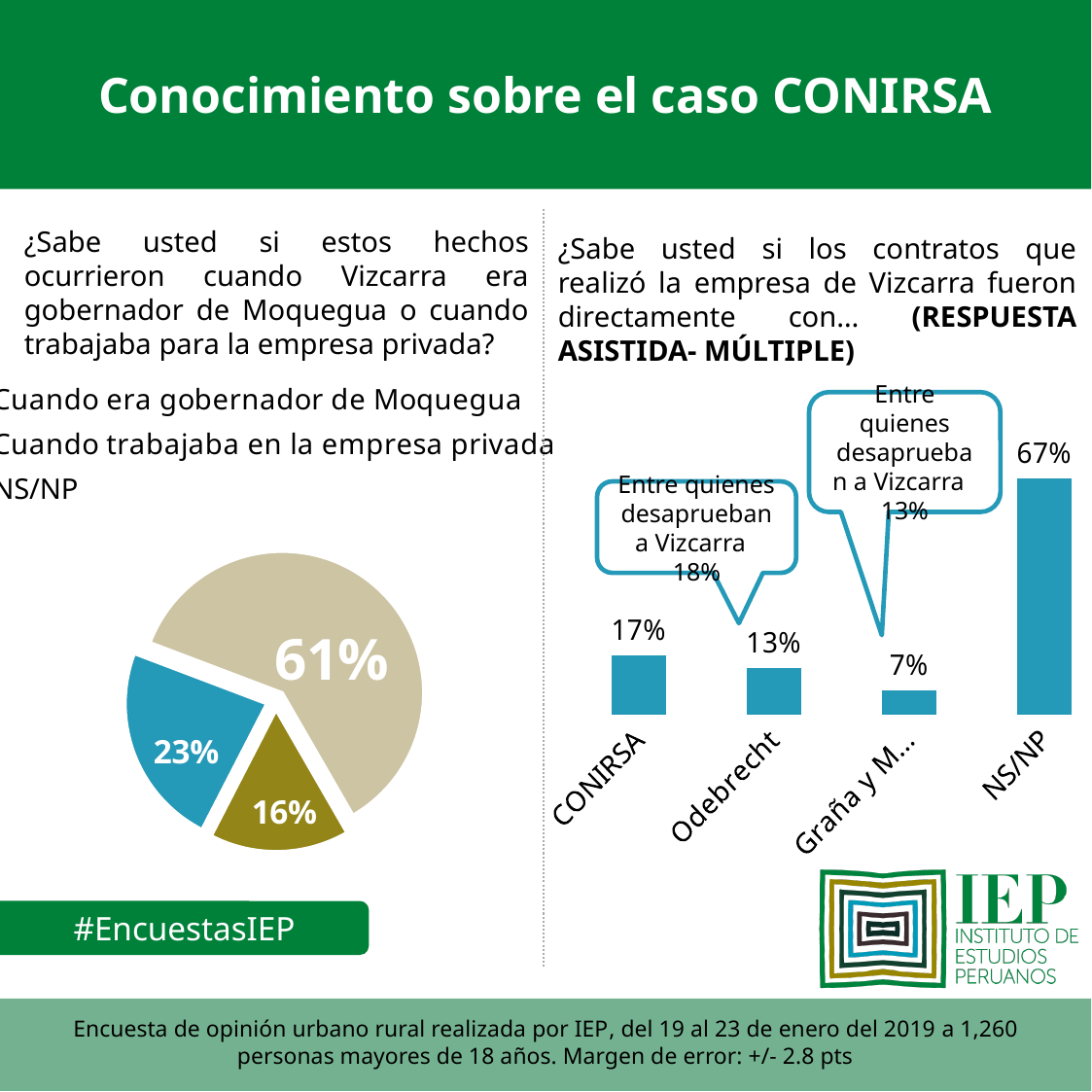
In the bar chart on the right, what is the value for Odebrecht? 13% What kind of chart is shown on the right side of the slide? Bar chart In the bar chart on the right, which category has the highest value? NS/NP In the bar chart on the right, what is the value for CONIRSA? 17% In the bar chart on the right, what is the difference between the NS/NP value and the CONIRSA value? 50 percentage points In the bar chart on the right, which category has the lowest value? Graña y M… In the bar chart on the right, what value does the callout give for Odebrecht among those who disapprove of Vizcarra? 18% In the pie chart on the left, how many slices are there? 3 In the bar chart on the right, what is the value for NS/NP? 67% In the bar chart on the right, how many bars are plotted? 4 In the pie chart on the left, what is the value of the largest slice? 61% In the bar chart on the right, which is larger, the value for CONIRSA or the value for Odebrecht? CONIRSA